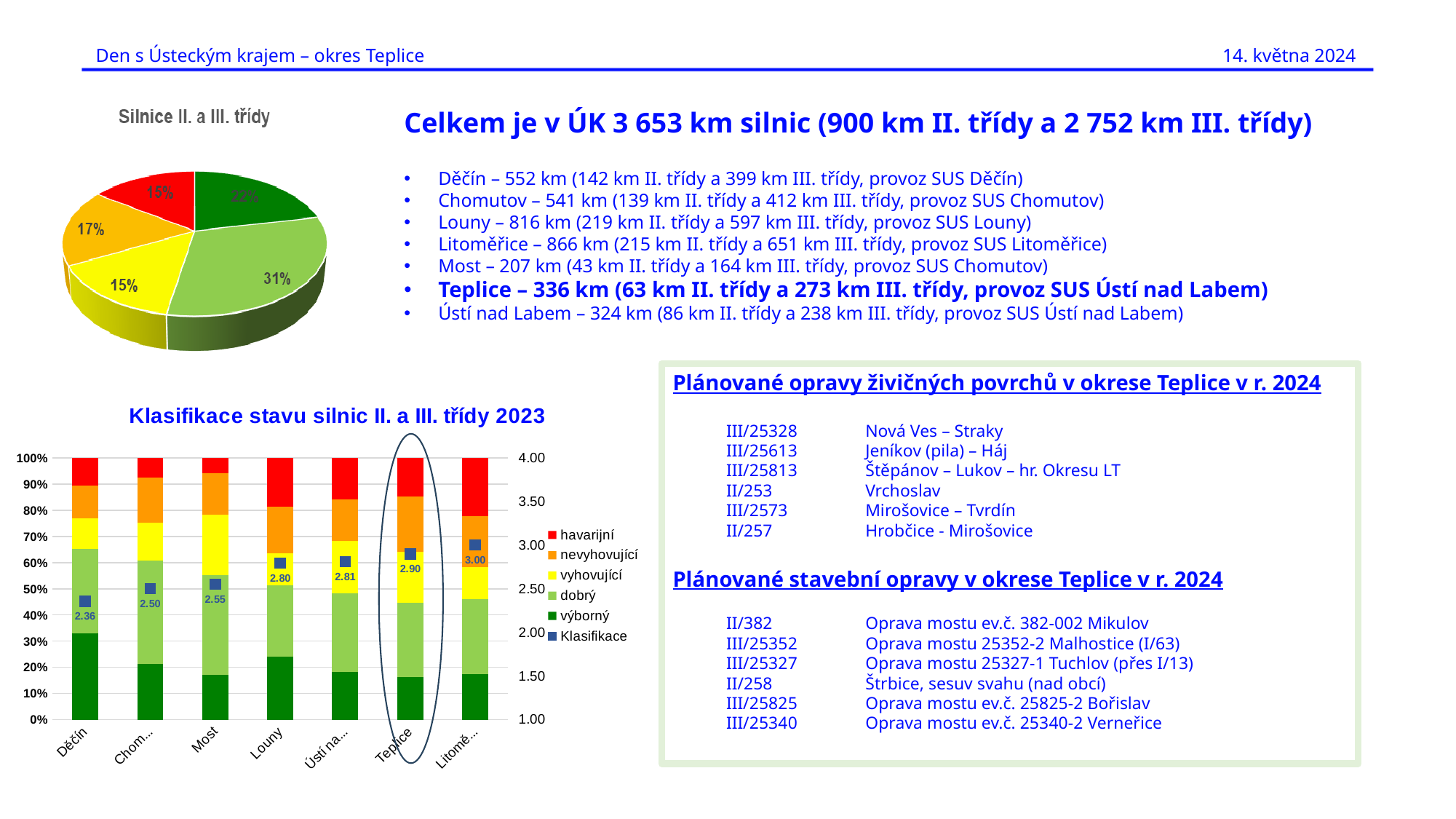
In the chart 'Klasifikace stavu silnic II. a III. třídy 2023', is the 'výborný' share for Děčín greater or less than 30%? greater What kind of chart is 'Klasifikace stavu silnic II. a III. třídy 2023'? combination chart: a 100% stacked bar chart with a marker (line) series for Klasifikace In the chart 'Klasifikace stavu silnic II. a III. třídy 2023', what is the difference between the Klasifikace values for Teplice and Děčín? 0.54 In the chart 'Klasifikace stavu silnic II. a III. třídy 2023', how many districts are shown on the x axis? 7 How many slices does the pie chart 'Silnice II. a III. třídy' have? 5 In the chart 'Klasifikace stavu silnic II. a III. třídy 2023', do the Klasifikace values rise or fall from left to right along the x axis? rise In the chart 'Klasifikace stavu silnic II. a III. třídy 2023', which has the higher Klasifikace value, Louny or Most? Louny In the chart 'Klasifikace stavu silnic II. a III. třídy 2023', what is the Klasifikace value for Teplice? 2.90 In the chart 'Klasifikace stavu silnic II. a III. třídy 2023', how many entries does the legend list? 6 In the chart 'Klasifikace stavu silnic II. a III. třídy 2023', which district has the lowest Klasifikace value? Děčín In the chart 'Klasifikace stavu silnic II. a III. třídy 2023', what is the Klasifikace value for Děčín? 2.36 In the pie chart 'Silnice II. a III. třídy', what is the share of the largest slice? 31%